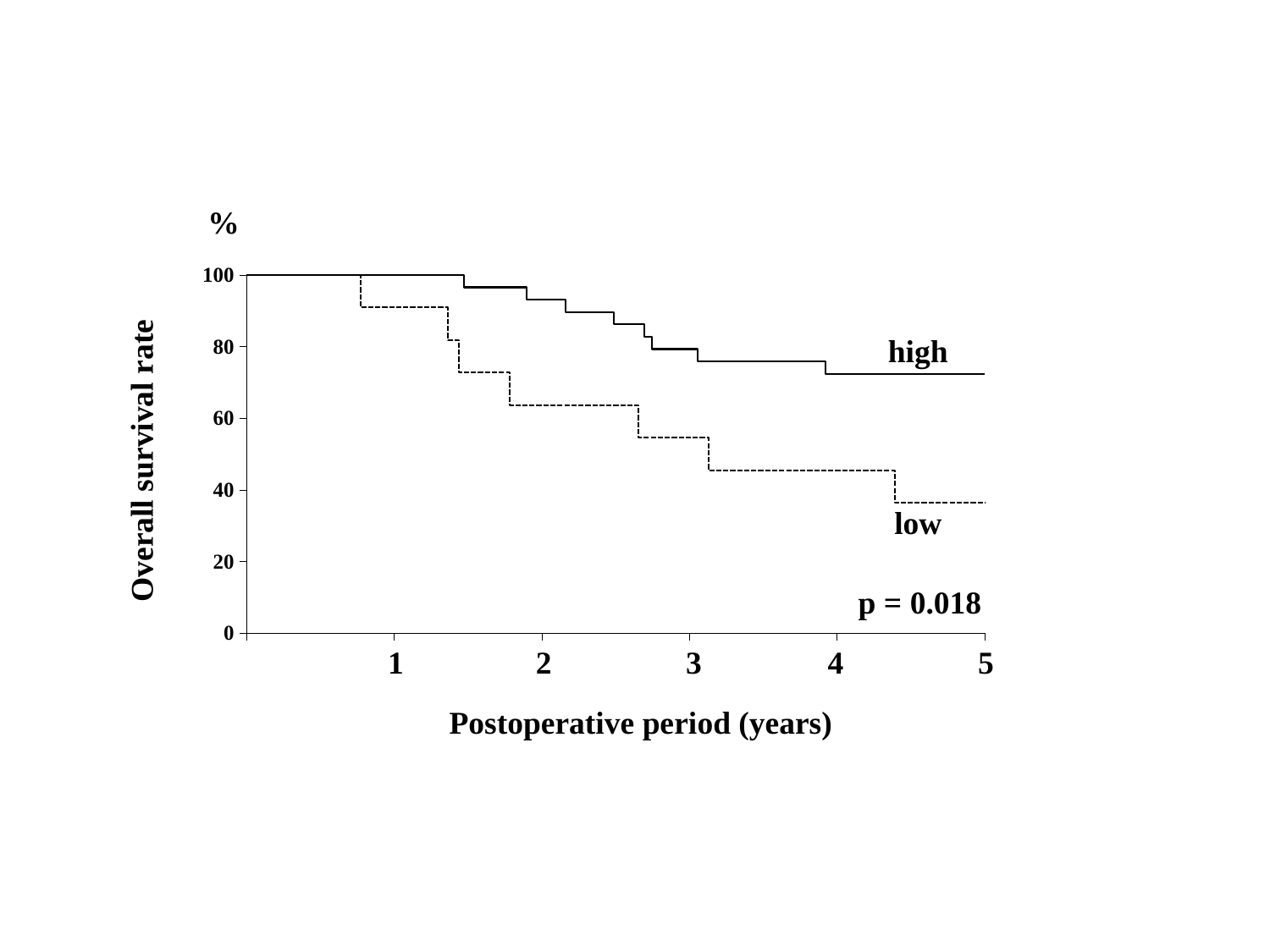
What is the overall survival rate for the high series at 1 year? 100 Which series has the higher overall survival rate at 5 years, high or low? high What kind of chart is shown on the slide? line chart Do the survival curves rise or fall as the postoperative period increases? fall Is the overall survival rate for the low series at 2 years greater or less than 80? less Which series has the lower overall survival rate at 3 years, high or low? low What are the names of the two series plotted on the chart? high and low Is the overall survival rate for the low series at 5 years greater or less than 40? less What is the p value shown on the chart? p = 0.018 Is the overall survival rate for the high series at 5 years greater or less than 60? greater How many series are plotted on the chart? 2